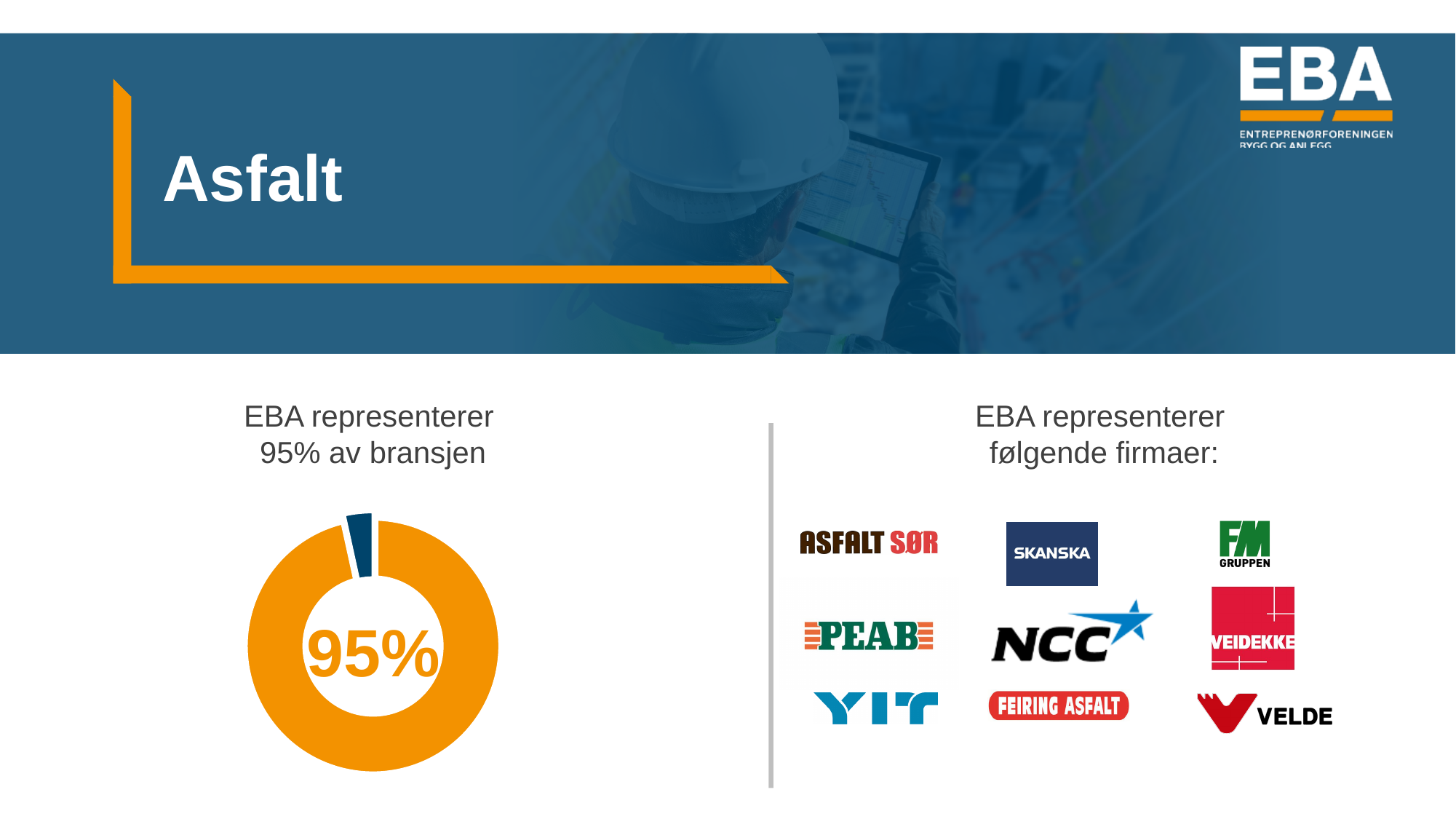
What is the value of the largest slice in the doughnut chart? 95% What text appears directly above the doughnut chart? EBA representerer 95% av bransjen Is the share shown by the orange slice greater or less than 50%? greater What colour is the large slice of the doughnut chart? orange What kind of chart is shown on the left side of the slide? doughnut chart How many slices does the doughnut chart have? 2 According to the chart, what share of the asphalt industry does EBA represent? 95% Which slice of the doughnut chart is larger, the orange one or the dark blue one? the orange one What percentage is printed in the centre of the doughnut chart? 95%